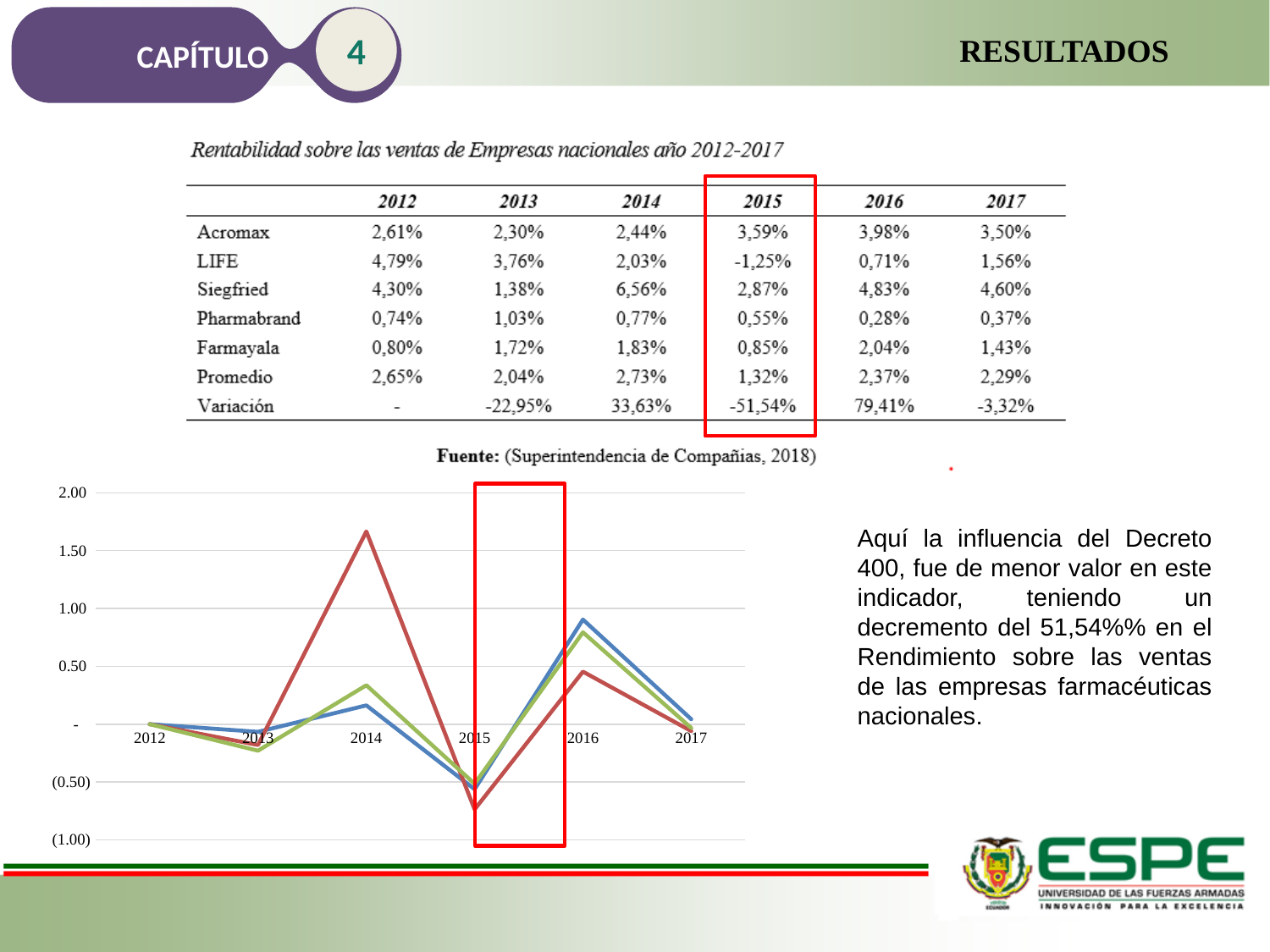
What kind of chart is shown at the bottom left of the slide? line chart In the line chart, which line has the larger value in 2016, the blue line or the red line? blue line In the line chart, is the value of the red line in 2015 greater or less than (0.50)? less How many years are shown on the x axis of the line chart? 6 In the line chart, do the three lines rise or fall from 2016 to 2017? fall How many lines are plotted in the line chart? 3 In the line chart, in which year does the red line reach its lowest value? 2015 In the line chart, which line has the larger value in 2014, the red line or the blue line? red line In the line chart, in which year does the red line reach its highest value? 2014 In the line chart, is the value of the blue line in 2016 greater or less than 1.00? less In the line chart, is the value of the red line in 2014 greater or less than 1.50? greater In the line chart, in which year does the blue line reach its highest value? 2016